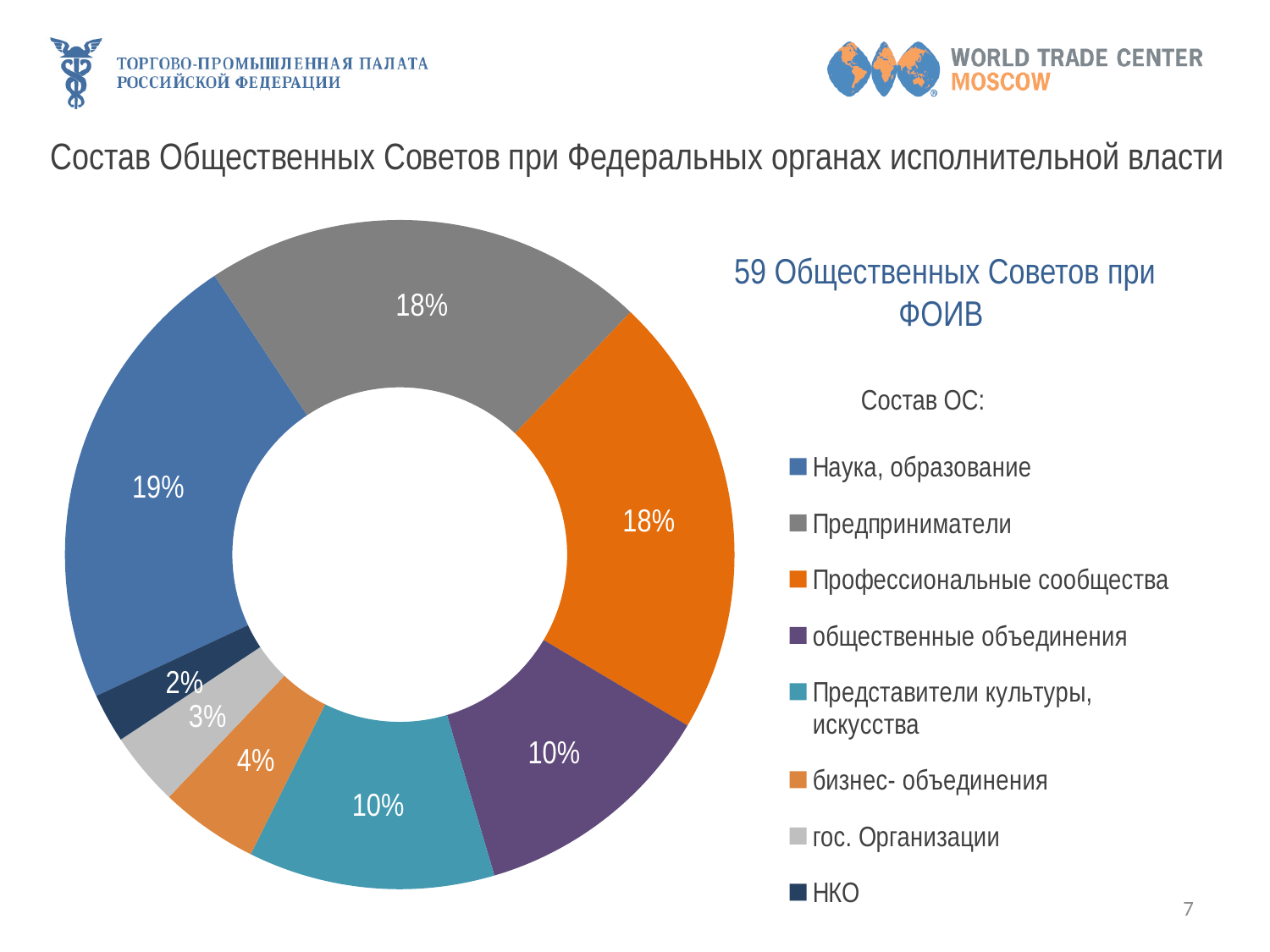
What colour is the slice for Профессиональные сообщества? Orange What share is shown for Предприниматели? 18% What share is shown for НКО? 2% What share of the chart is labelled for Наука, образование? 19% What share is shown for Представители культуры, искусства? 10% Which is larger, the share for гос. Организации or the share for бизнес- объединения? бизнес- объединения What is the difference between the shares of Профессиональные сообщества and общественные объединения? 8% How many categories does the legend list? 8 What kind of chart is shown on the slide? Doughnut (pie) chart What share is shown for бизнес- объединения? 4% Which category has the smallest share in the chart? НКО Which category has the largest share in the chart? Наука, образование